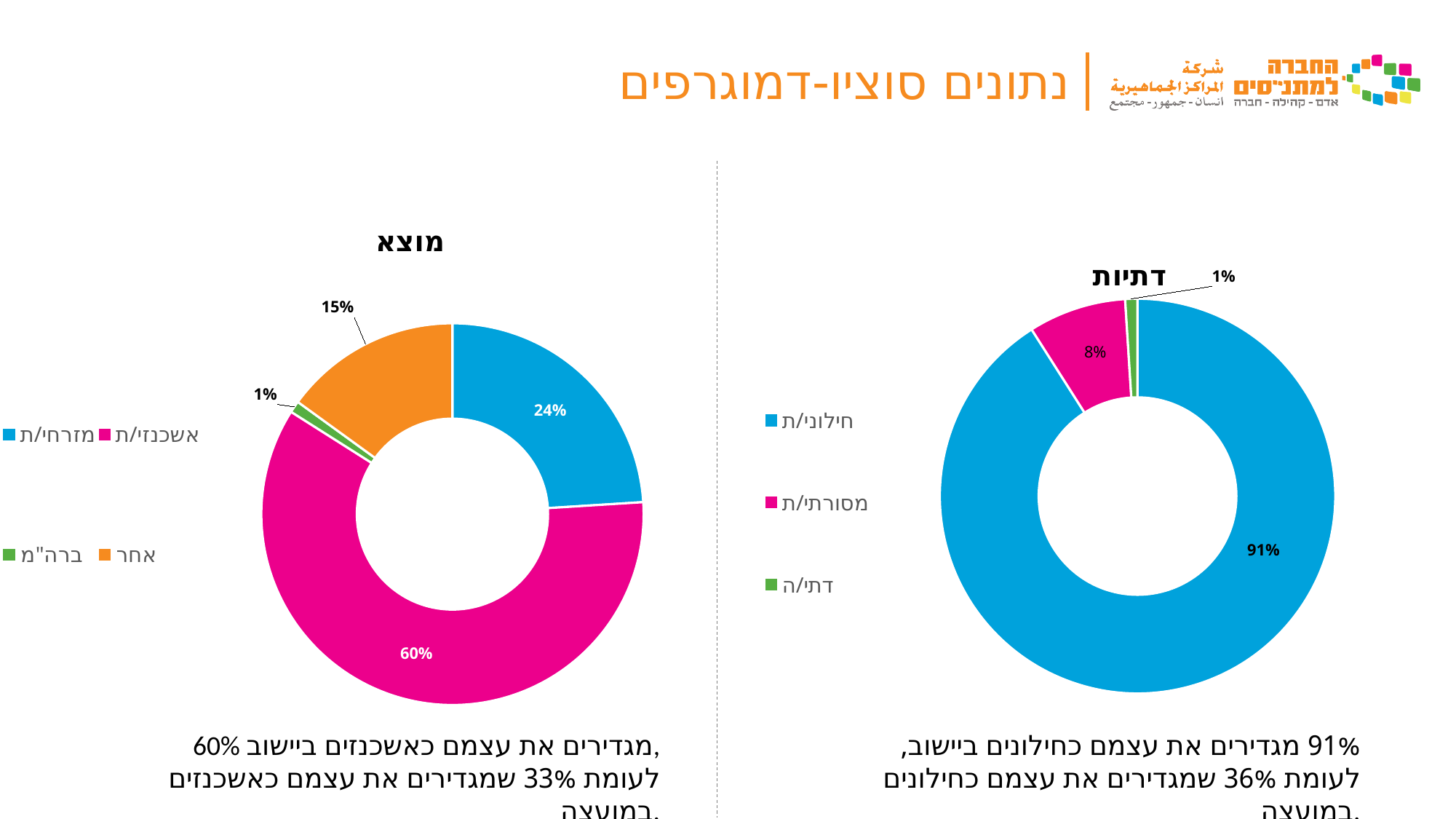
How many categories does the legend of the "מוצא" chart list? 4 In the "מוצא" chart, what percentage is shown for מזרחי/ת? 24% In the "מוצא" chart, what is the difference between the shares of אשכנזי/ת and מזרחי/ת? 36% In the "מוצא" chart, which category has the smallest share? ברה"מ How many categories does the legend of the "דתיות" chart list? 3 In the "מוצא" chart, what percentage is shown for אשכנזי/ת? 60% In the "דתיות" chart, what percentage is shown for מסורתי/ת? 8% What kind of chart is the "דתיות" chart? Pie (donut) chart In the "דתיות" chart, which is larger, the share of מסורתי/ת or the share of דתי/ה? מסורתי/ת In the "מוצא" chart, which category has the largest share? אשכנזי/ת In the "דתיות" chart, what percentage is shown for חילוני/ת? 91% In the "מוצא" chart, what percentage is shown for אחר? 15%